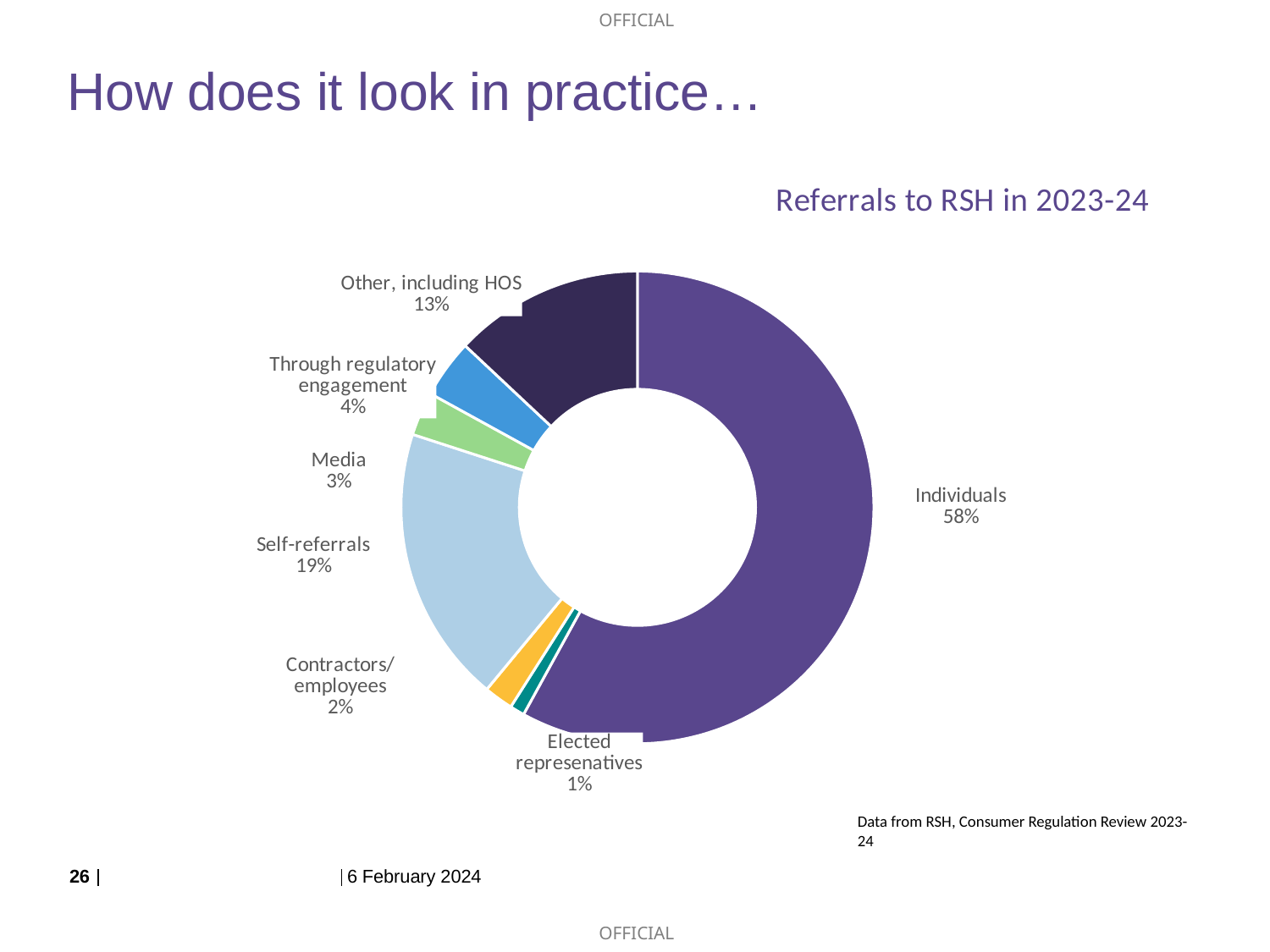
What percentage of referrals came from Media? 3% What type of chart is shown on the slide? Doughnut chart Which category accounts for the smallest share of referrals? Elected represenatives Which category accounts for the largest share of referrals? Individuals What share of referrals came through regulatory engagement? 4% What percentage of referrals were Self-referrals? 19% How many categories are shown in the chart? 7 How many percentage points larger is the Individuals share than the Self-referrals share? 39 What is the combined share of Contractors/employees and Elected represenatives? 3% Which is larger: the share for Other, including HOS or the share for Self-referrals? Self-referrals What is the title of the chart? Referrals to RSH in 2023-24 What share of referrals to RSH in 2023-24 came from Individuals? 58%